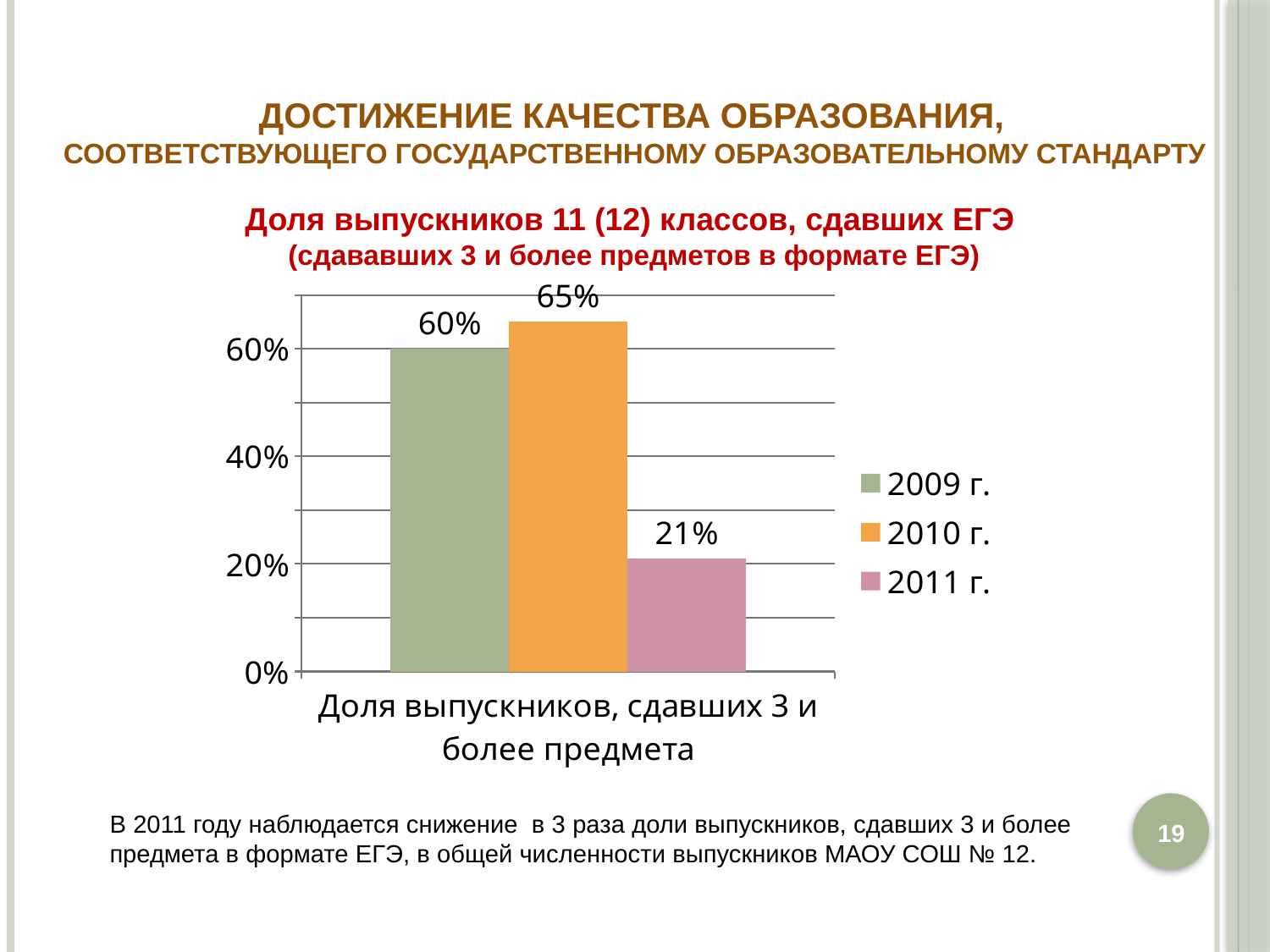
How many series does the legend list? 3 What is the value for 2009 г.? 60% Which year has the highest value? 2010 г. What is the value for 2011 г.? 21% Which year has the lowest value? 2011 г. What is the value for 2010 г.? 65% What kind of chart is shown on the slide? bar chart What is the difference between the values for 2010 г. and 2009 г.? 5% What is the difference between the values for 2010 г. and 2011 г.? 44% Which is larger, the value for 2009 г. or the value for 2011 г.? 2009 г. What colour is the bar for 2010 г.? orange Is the value for 2011 г. greater or less than 40%? less